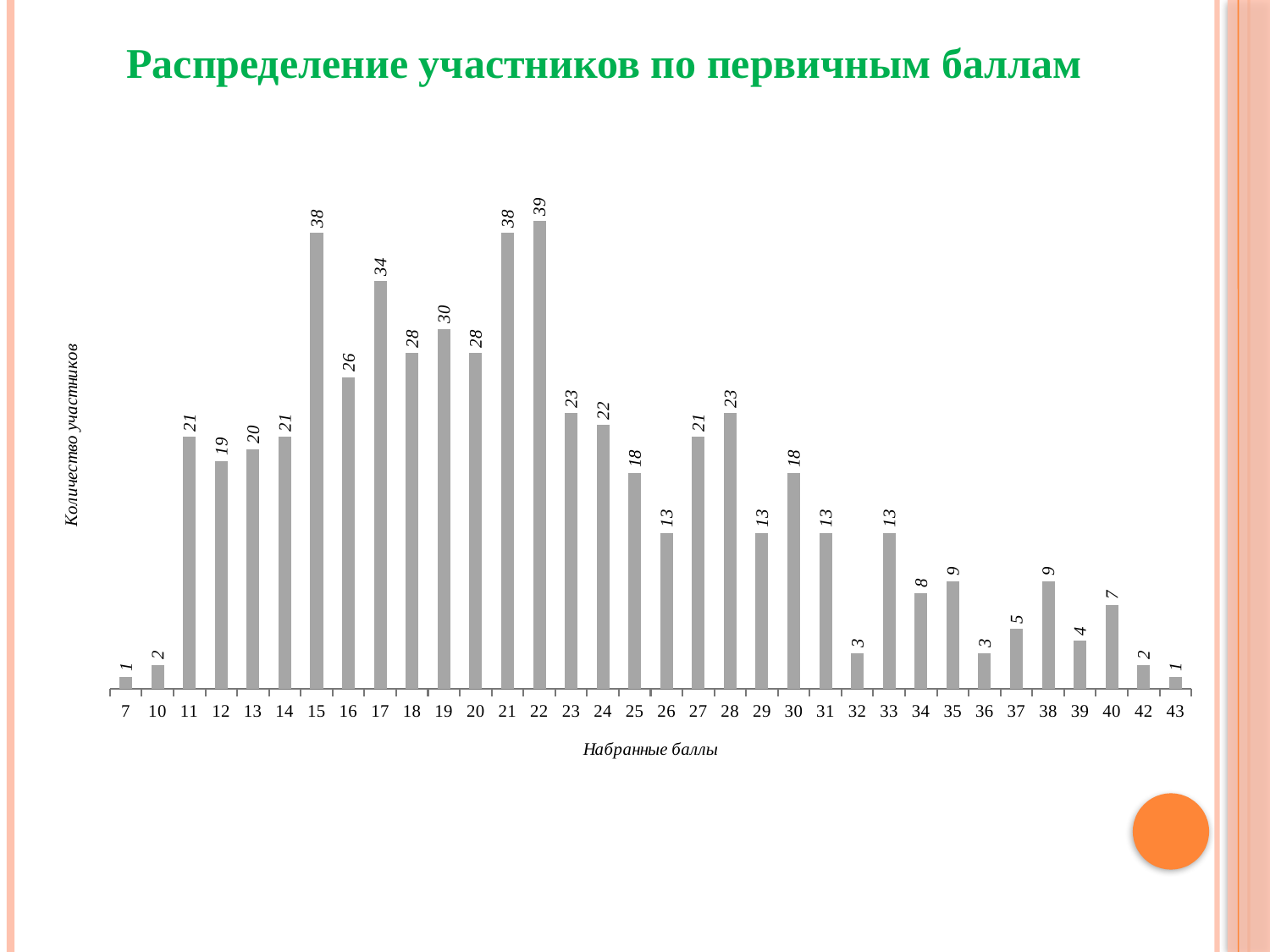
How many participants scored 17 points? 34 How many participants scored 33 points? 13 Which has more participants: a score of 19 or a score of 25? 19 What is the difference between the number of participants with 15 points and with 16 points? 12 What is the difference between the number of participants with 22 points and with 23 points? 16 How many participants scored 22 points? 39 How many participants scored 40 points? 7 What is the title of the chart? Распределение участников по первичным баллам Which has more participants: a score of 35 or a score of 37? 35 What type of chart is shown on the slide? Bar chart How many score categories are shown on the x axis? 34 Which score has the highest number of participants? 22